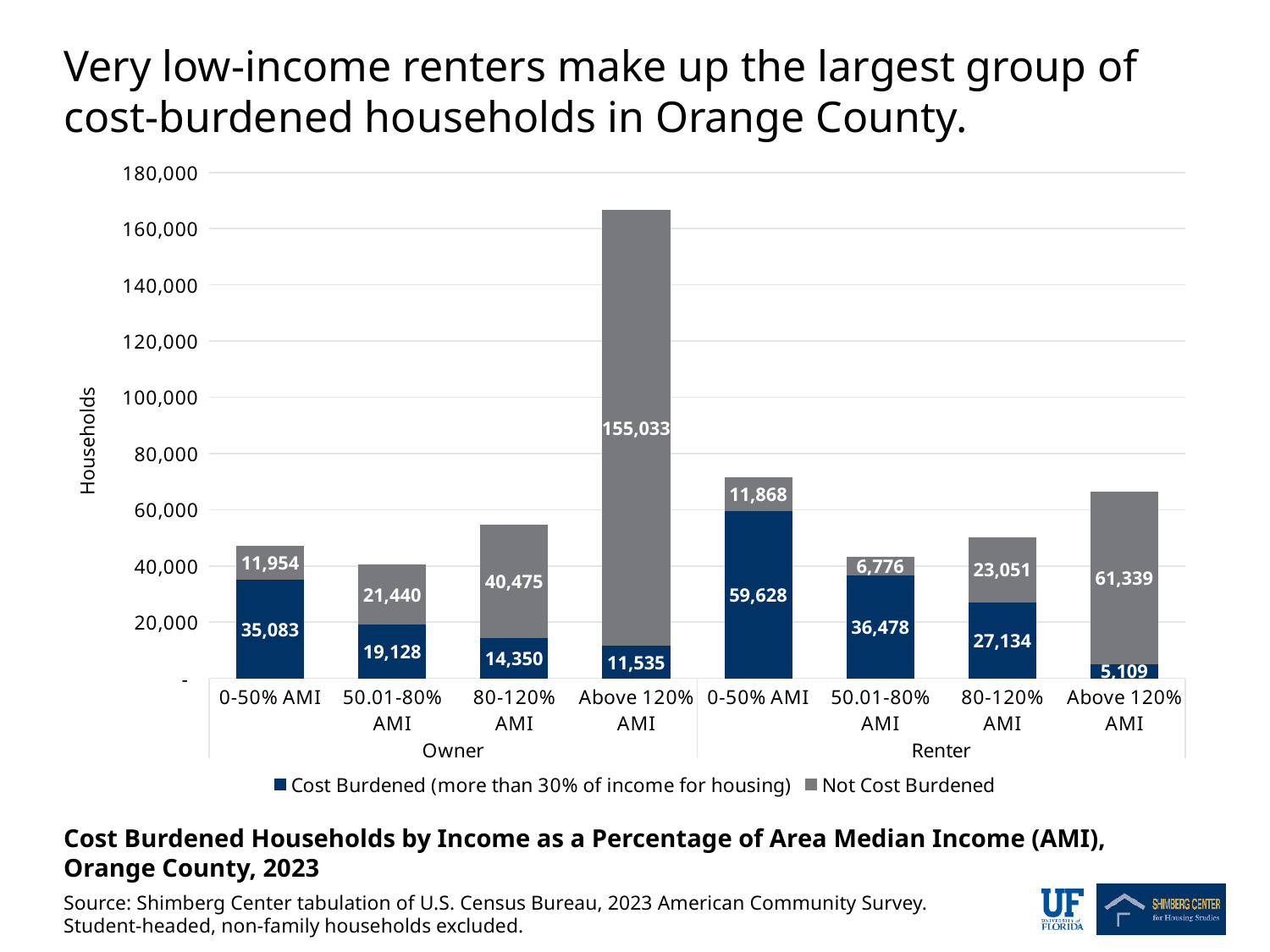
What is the number of not-cost-burdened owner households in the Above 120% AMI group? 155,033 How many series does the legend list? 2 What is the total number of households in the Owner Above 120% AMI bar? 166,568 Which group has the smallest number of cost-burdened households? Renter, Above 120% AMI Which is larger: the number of not-cost-burdened renter households in the 80-120% AMI group or in the 50.01-80% AMI group? 80-120% AMI Which group has the largest number of cost-burdened households? Renter, 0-50% AMI How many cost-burdened renter households are in the 0-50% AMI group? 59,628 How many income groups (bars) are shown in the chart? 8 What is the total number of households in the Renter 0-50% AMI bar? 71,496 What type of chart is shown on the slide? Stacked bar chart How many cost-burdened owner households are in the 80-120% AMI group? 14,350 What is the difference between cost-burdened renter households and cost-burdened owner households in the 0-50% AMI group? 24,545